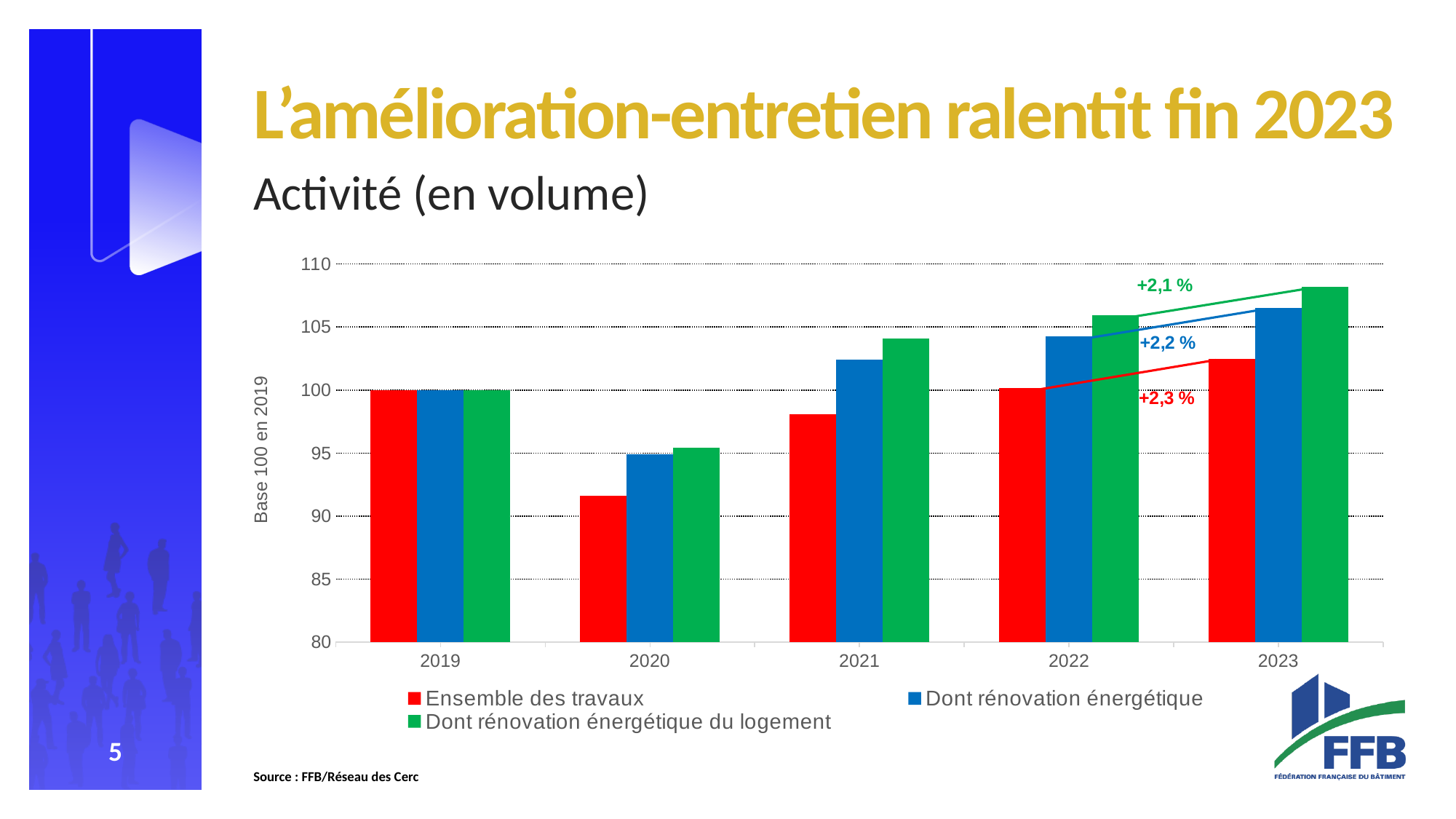
Do the values for Ensemble des travaux rise or fall from 2020 to 2023? rise How many years are shown on the x axis of the chart? 5 What is the value for Ensemble des travaux in 2019? 100 Is the value for Dont rénovation énergétique du logement in 2023 greater or less than 105? greater In which year is the value for Ensemble des travaux lowest? 2020 In which year is the value for Dont rénovation énergétique du logement highest? 2023 In 2023, which is larger: Ensemble des travaux or Dont rénovation énergétique du logement? Dont rénovation énergétique du logement How many series does the chart's legend list? 3 What kind of chart is shown on the slide? bar chart Is the value for Ensemble des travaux in 2020 greater or less than 95? less Is the value for Ensemble des travaux in 2021 greater or less than 100? less What growth rate is annotated in green for Dont rénovation énergétique du logement between 2022 and 2023? +2,1 %